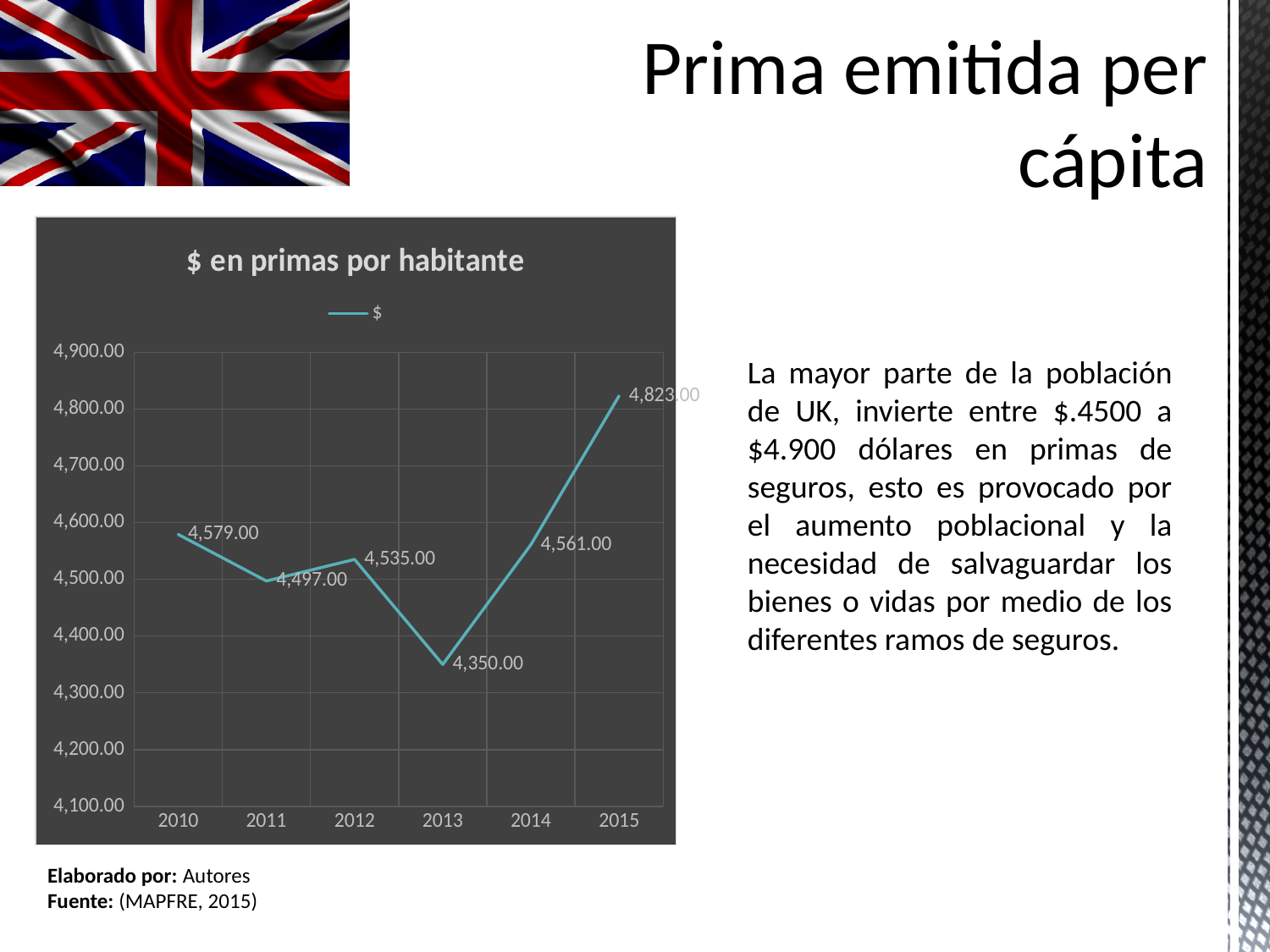
Which year has the highest value? 2015 Does the value rise or fall from 2013 to 2015? rise What is the title of the chart? $ en primas por habitante What is the value for 2012? 4,535.00 What kind of chart is shown? line chart What is the value for 2015? 4,823.00 What is the difference between the values for 2015 and 2013? 473.00 What is the value for 2013? 4,350.00 Which is larger, the value for 2011 or the value for 2014? 2014 How many years are plotted on the x axis? 6 Which year has the lowest value? 2013 What is the value for 2010? 4,579.00